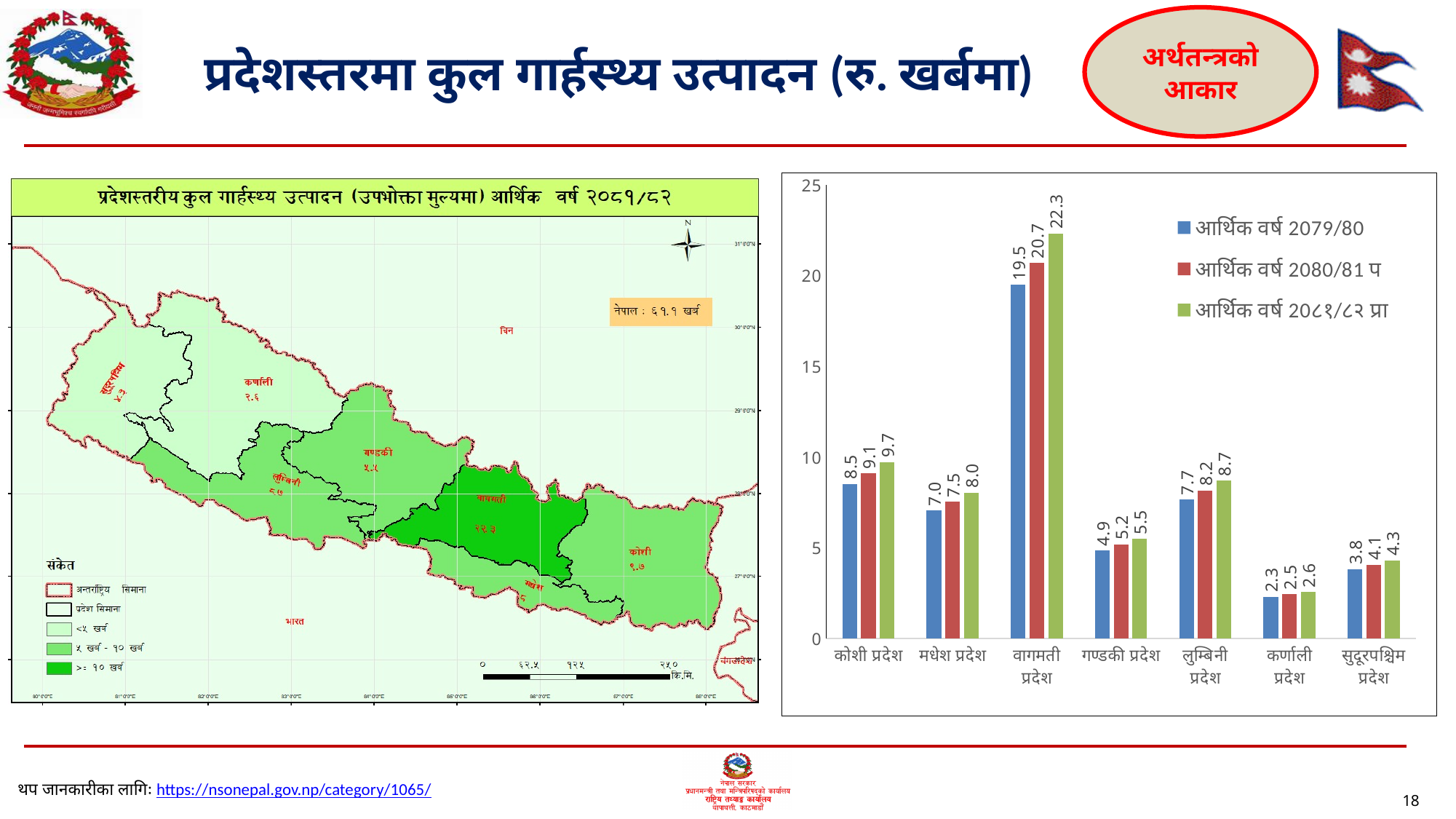
In the bar chart on the right, do the values for सुदूरपश्चिम प्रदेश rise or fall from आर्थिक वर्ष 2079/80 to आर्थिक वर्ष २०८१/८२ प्रा? rise In the bar chart on the right, which province has the highest value in आर्थिक वर्ष २०८१/८२ प्रा? वागमती प्रदेश How many series does the legend of the bar chart on the right list? 3 In the bar chart on the right, which province has the lowest value in आर्थिक वर्ष 2079/80? कर्णाली प्रदेश How many provinces are shown on the x axis of the bar chart on the right? 7 In the bar chart on the right, what is the value for वागमती प्रदेश in आर्थिक वर्ष २०८१/८२ प्रा? 22.3 In the bar chart on the right, which is larger in आर्थिक वर्ष 2080/81 प: मधेश प्रदेश or लुम्बिनी प्रदेश? लुम्बिनी प्रदेश In the bar chart on the right, what is the difference between the आर्थिक वर्ष २०८१/८२ प्रा value and the आर्थिक वर्ष 2079/80 value for वागमती प्रदेश? 2.8 In the bar chart on the right, is the value for गण्डकी प्रदेश in आर्थिक वर्ष 2079/80 greater or less than 5? less In the bar chart on the right, what is the value for लुम्बिनी प्रदेश in आर्थिक वर्ष 2080/81 प? 8.2 In the bar chart on the right, what is the value for कोशी प्रदेश in आर्थिक वर्ष 2079/80? 8.5 What kind of chart is shown on the right side of the slide? bar chart